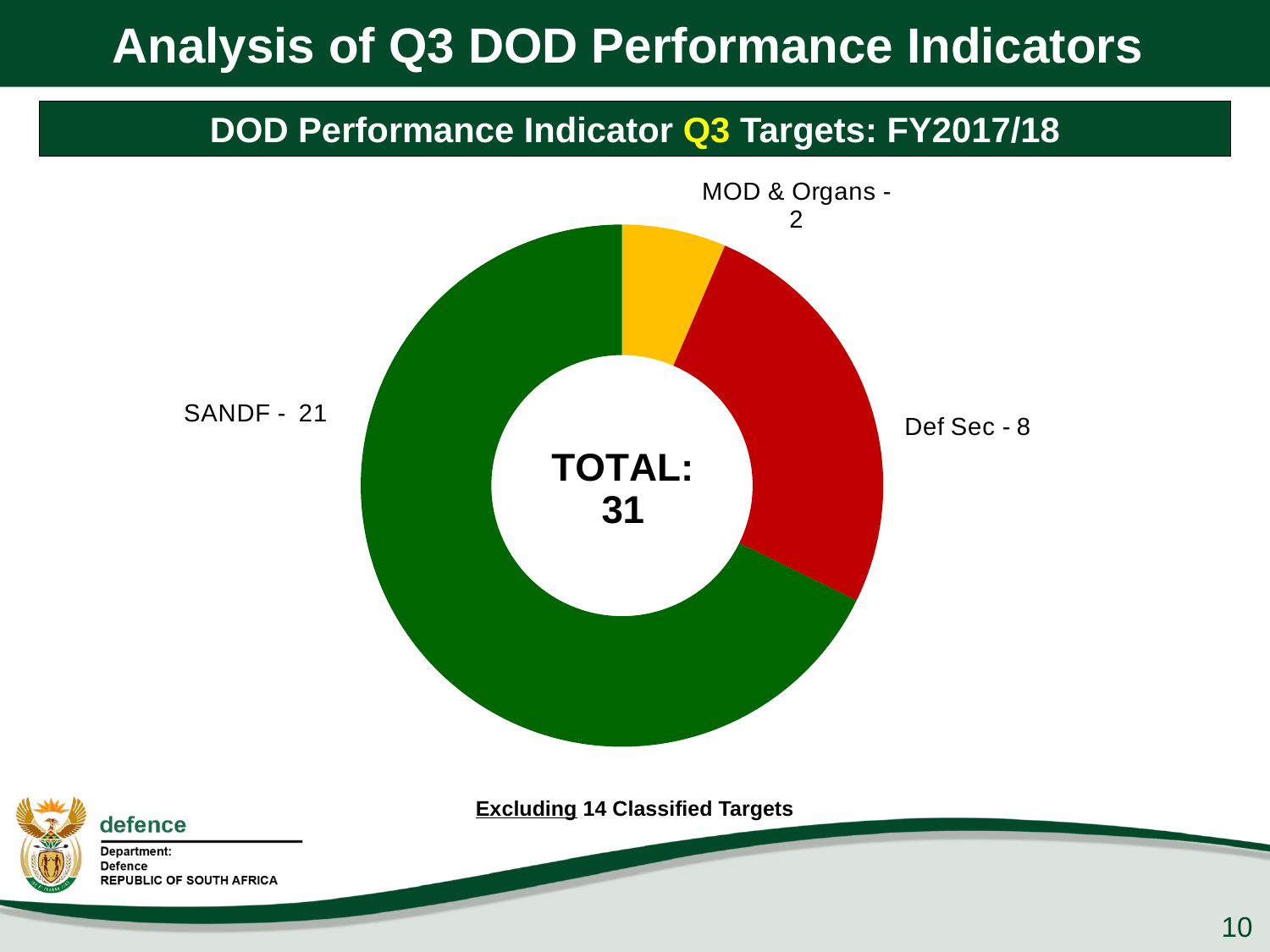
What colour is the SANDF segment of the chart? Green Which has more Q3 targets, Def Sec or MOD & Organs? Def Sec How many Q3 targets does SANDF have? 21 What is the total number of Q3 targets shown in the centre of the chart? 31 How many Q3 targets does Def Sec have? 8 Which category has the fewest Q3 targets? MOD & Organs Which category has the most Q3 targets? SANDF What is the difference between the SANDF and Def Sec target counts? 13 What kind of chart is shown on the slide? Doughnut chart How many Q3 targets does MOD & Organs have? 2 How many categories are shown in the chart? 3 What is the title of the chart? DOD Performance Indicator Q3 Targets: FY2017/18